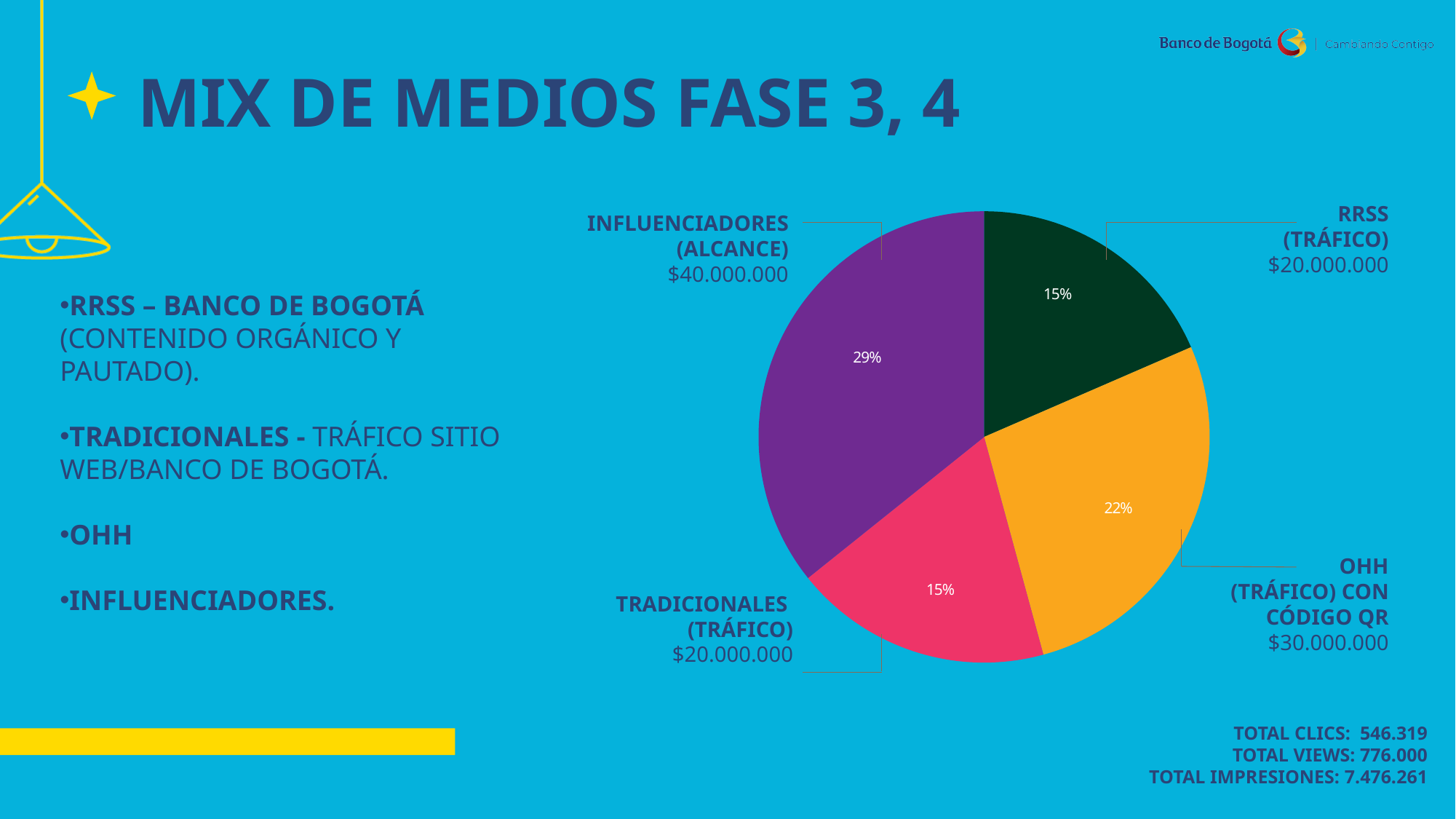
What colour is the INFLUENCIADORES (ALCANCE) slice? purple What is the title of the slide containing the pie chart? MIX DE MEDIOS FASE 3, 4 What kind of chart is shown on the slide? pie chart What percentage label is shown on the OHH (TRÁFICO) CON CÓDIGO QR slice? 22% What is the value shown for RRSS (TRÁFICO)? $20.000.000 What percentage label is shown on the INFLUENCIADORES (ALCANCE) slice? 29% Which category has the largest slice of the pie? INFLUENCIADORES (ALCANCE) What is the value shown for OHH (TRÁFICO) CON CÓDIGO QR? $30.000.000 Which is larger, the value for OHH (TRÁFICO) CON CÓDIGO QR or the value for TRADICIONALES (TRÁFICO)? OHH (TRÁFICO) CON CÓDIGO QR What is the difference between the values for INFLUENCIADORES (ALCANCE) and OHH (TRÁFICO) CON CÓDIGO QR? $10.000.000 What is the value shown for INFLUENCIADORES (ALCANCE)? $40.000.000 How many slices does the pie chart have? 4